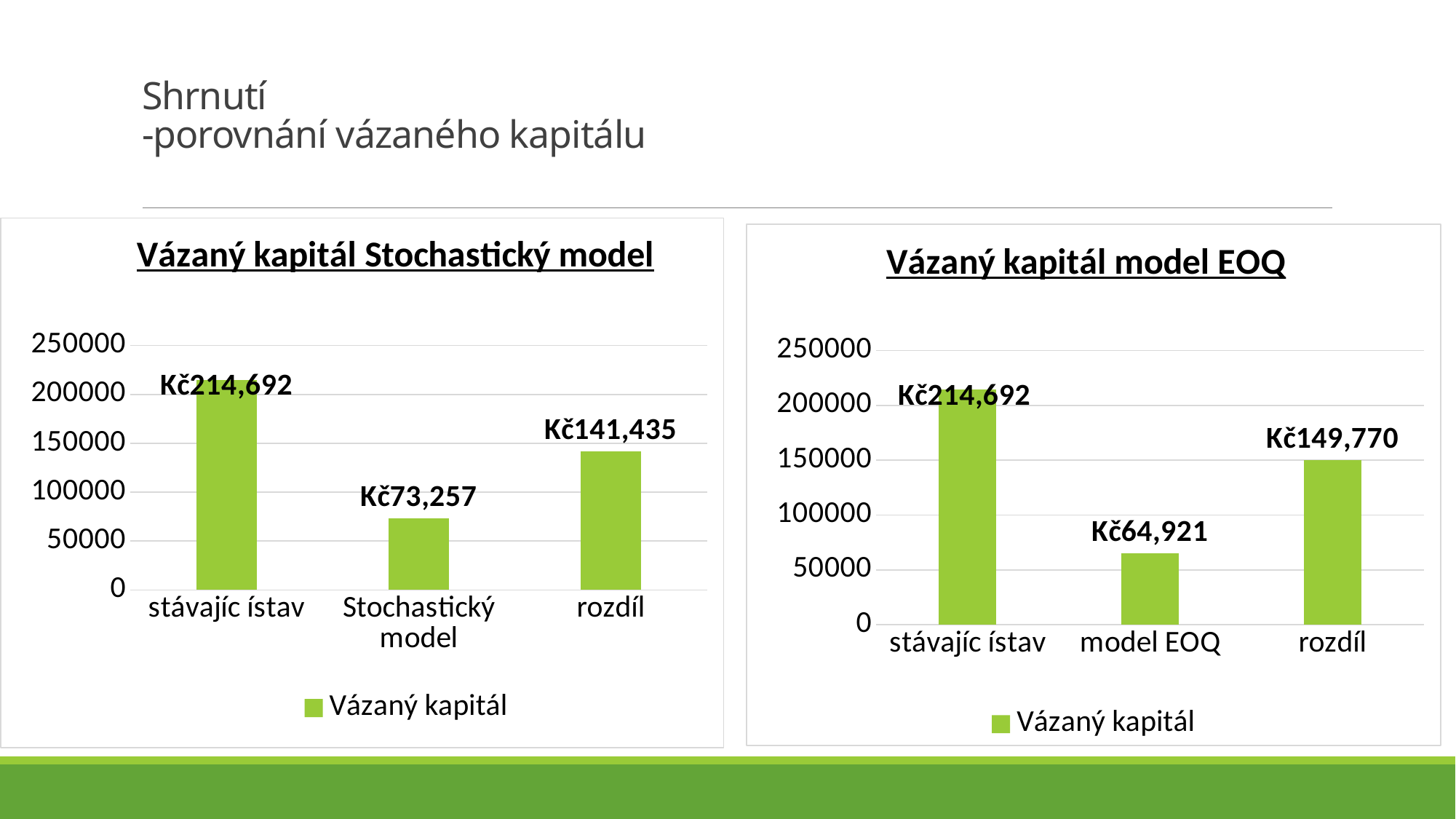
How many categories are shown in the chart titled 'Vázaný kapitál model EOQ'? 3 In the chart titled 'Vázaný kapitál model EOQ', what is the difference between 'stávajíc ístav' and 'model EOQ'? Kč149,771 In the chart titled 'Vázaný kapitál Stochastický model', is the value for 'rozdíl' greater or less than 100000? greater In the chart titled 'Vázaný kapitál model EOQ', what is the value for 'rozdíl'? Kč149,770 In the chart titled 'Vázaný kapitál Stochastický model', what is the difference between 'stávajíc ístav' and 'Stochastický model'? Kč141,435 How many series does the legend list in the chart titled 'Vázaný kapitál Stochastický model'? 1 What kind of chart is the chart titled 'Vázaný kapitál model EOQ'? bar chart In the chart titled 'Vázaný kapitál model EOQ', what is the value for 'model EOQ'? Kč64,921 Which is larger: 'rozdíl' in the chart titled 'Vázaný kapitál Stochastický model' or 'rozdíl' in the chart titled 'Vázaný kapitál model EOQ'? rozdíl in Vázaný kapitál model EOQ In the chart titled 'Vázaný kapitál Stochastický model', which category has the highest value? stávajíc ístav In the chart titled 'Vázaný kapitál model EOQ', which category has the lowest value? model EOQ In the chart titled 'Vázaný kapitál Stochastický model', what is the value for 'Stochastický model'? Kč73,257